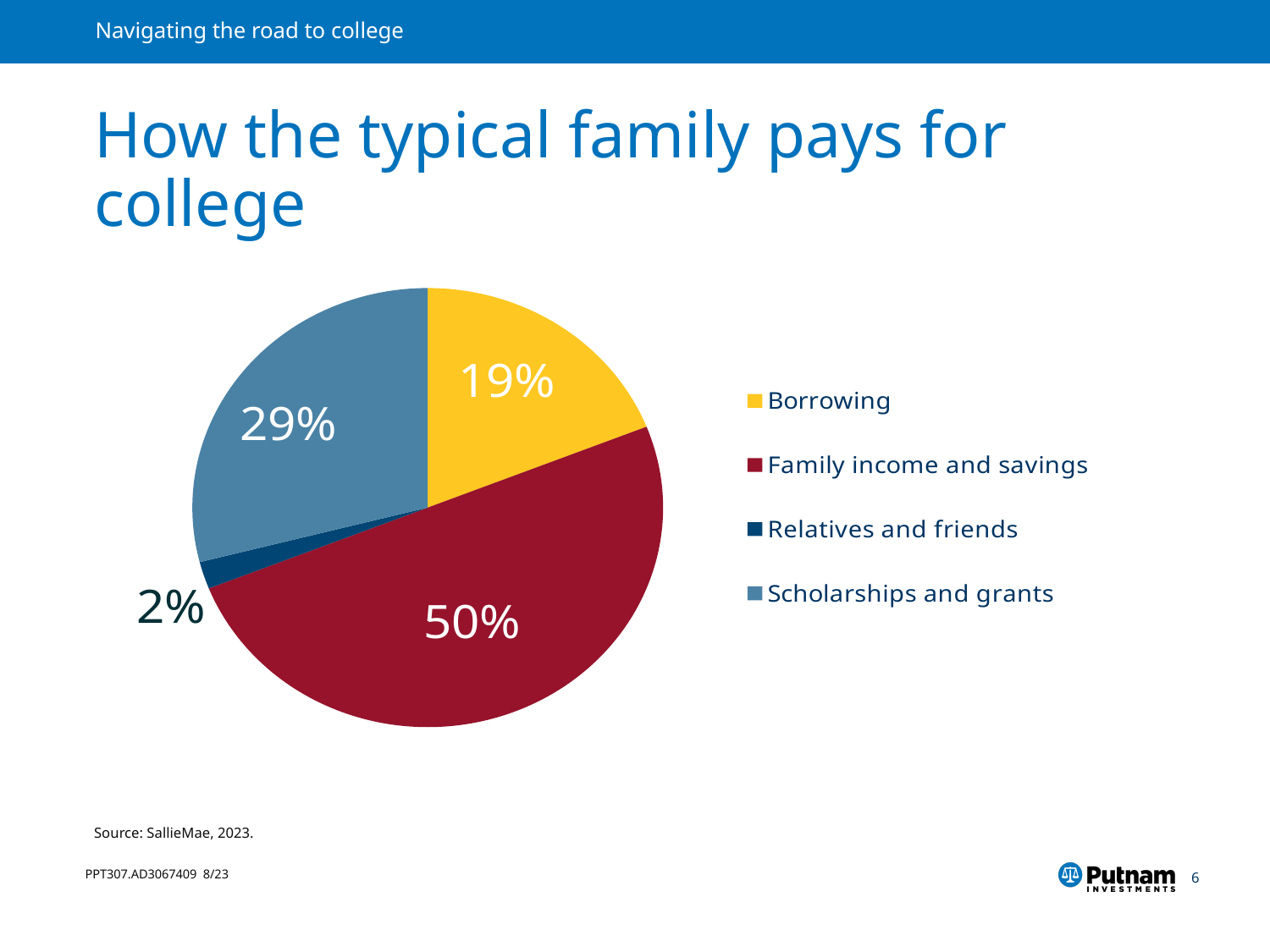
How many entries does the legend list? 4 What share of college costs comes from Family income and savings? 50% Which colour represents Borrowing in the pie chart? yellow Which source accounts for the smallest share of how the typical family pays for college? Relatives and friends Which source accounts for the largest share of how the typical family pays for college? Family income and savings How many percentage points larger is the Scholarships and grants share than the Borrowing share? 10% Which is larger: the share for Borrowing or the share for Scholarships and grants? Scholarships and grants What share of college costs comes from Scholarships and grants? 29% What share of college costs does Borrowing account for? 19% What kind of chart is shown on the slide? pie chart How many slices does the pie chart have? 4 What share of college costs comes from Relatives and friends? 2%